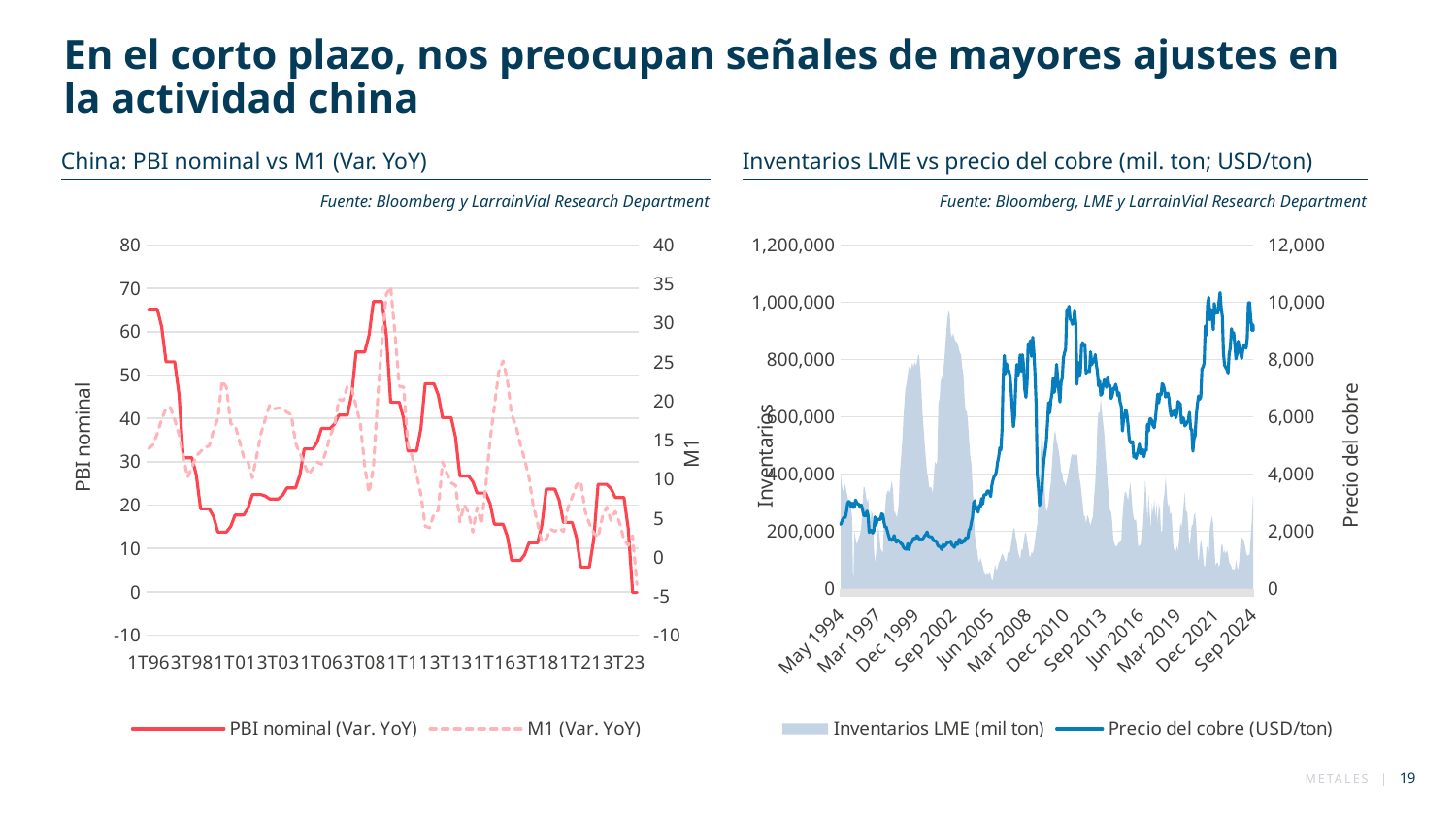
In the chart 'Inventarios LME vs precio del cobre (mil. ton; USD/ton)', is the Inventarios LME (mil ton) value around Sep 2002 greater or less than 800,000? greater In the chart 'Inventarios LME vs precio del cobre (mil. ton; USD/ton)', is the Precio del cobre (USD/ton) value around Dec 2021 greater or less than 8,000? greater In the chart 'China: PBI nominal vs M1 (Var. YoY)', which series is drawn with a dashed line? M1 (Var. YoY) In the chart 'China: PBI nominal vs M1 (Var. YoY)', what kind of chart is it? Line chart In the chart 'Inventarios LME vs precio del cobre (mil. ton; USD/ton)', does the Precio del cobre (USD/ton) series overall rise or fall from May 1994 to Sep 2024? rise In the chart 'Inventarios LME vs precio del cobre (mil. ton; USD/ton)', what is the first date label shown on the horizontal axis? May 1994 In the chart 'Inventarios LME vs precio del cobre (mil. ton; USD/ton)', how many series does the legend list? 2 In the chart 'China: PBI nominal vs M1 (Var. YoY)', how many series does the legend list? 2 In the chart 'China: PBI nominal vs M1 (Var. YoY)', is the value of PBI nominal (Var. YoY) at 1T96 greater or less than 50? greater In the chart 'China: PBI nominal vs M1 (Var. YoY)', does the PBI nominal (Var. YoY) series overall rise or fall from 1T96 to 3T23? fall In the chart 'China: PBI nominal vs M1 (Var. YoY)', what is the highest tick shown on the left vertical axis? 80